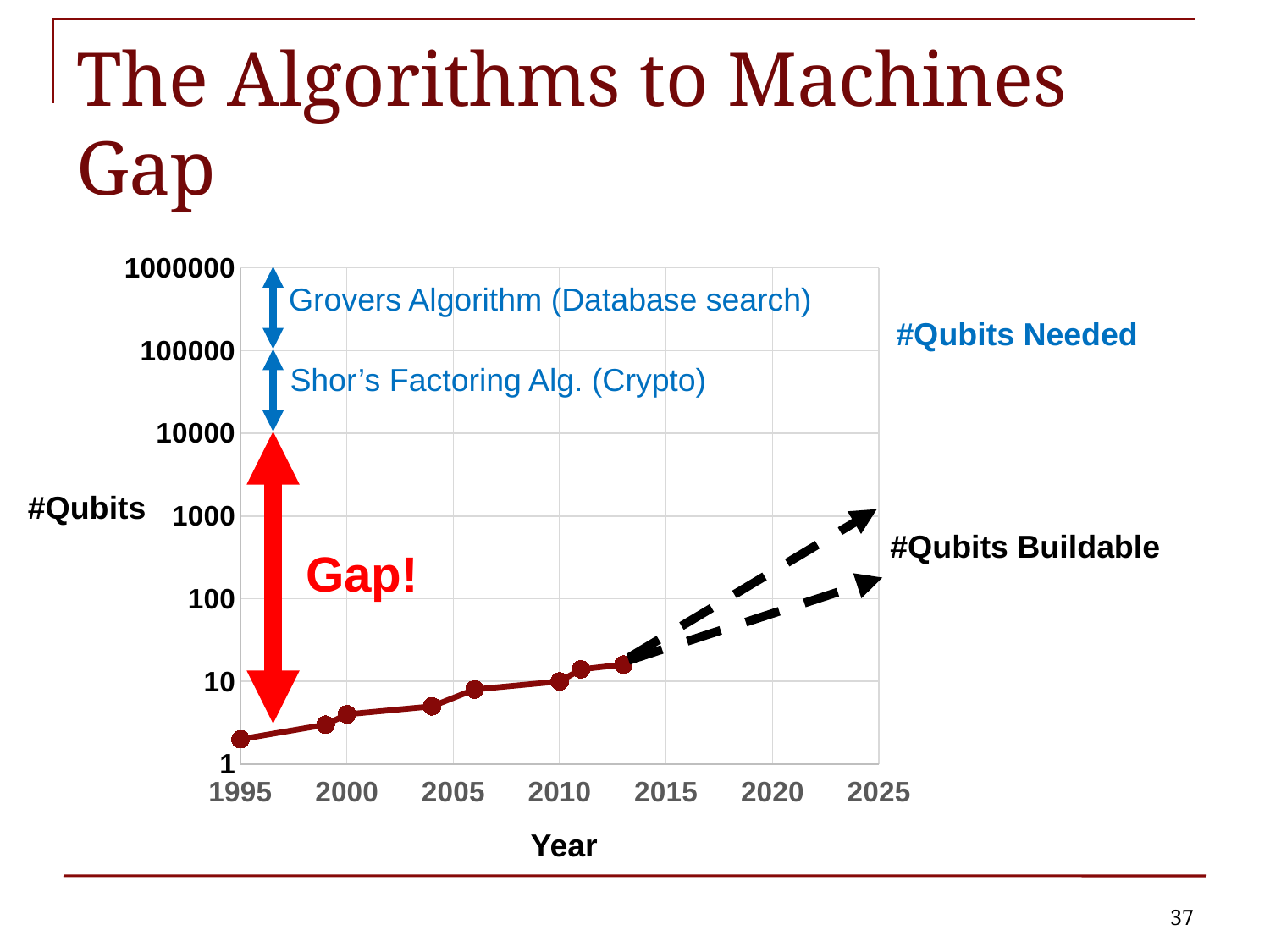
Which has the larger plotted value, 1995 or 2013? 2013 Is the plotted value for 2013 greater or less than 10? greater What kind of chart is shown on the slide? line chart Do the plotted #Qubits values rise or fall as the year increases from 1995 to 2013? rise Which year has the highest plotted #Qubits value? 2013 Is the plotted value for 2013 greater or less than 100? less Which algorithm is labelled in the range between 100000 and 1000000 qubits? Grovers Algorithm (Database search) How many data points are plotted on the solid line? 8 Which year has the lowest plotted #Qubits value? 1995 Is the plotted value for 1995 greater or less than 10? less What is the label on the x axis of the chart? Year